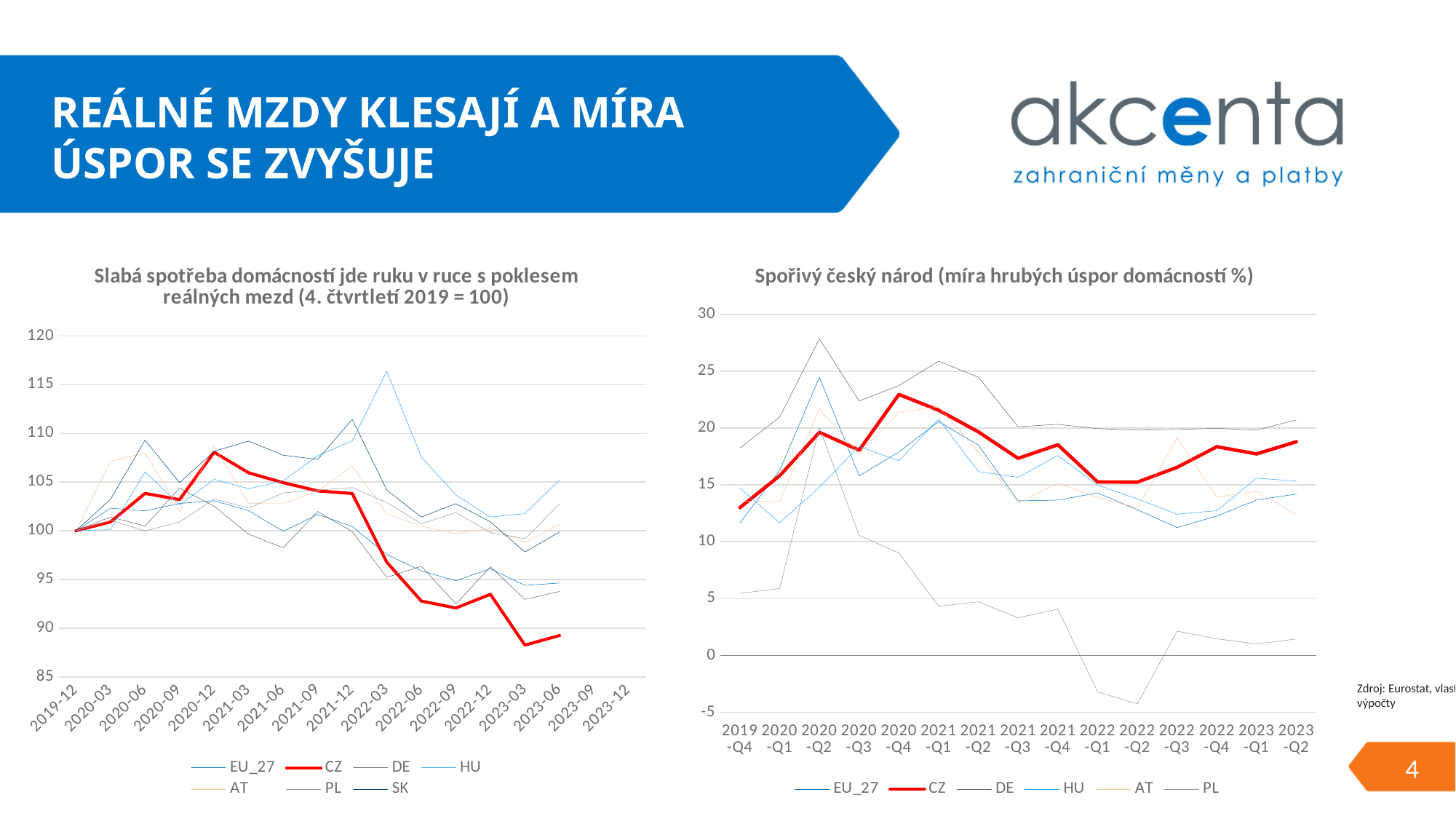
In the left chart (real wages index), which is larger at 2023-06: CZ or HU? HU In the left chart (real wages index), what is the value of CZ at 2019-12? 100 How many series does the legend of the right chart, 'Spořivý český národ', list? 6 In the left chart (real wages index), is the value for CZ at 2023-03 greater or less than 90? less In the right chart 'Spořivý český národ', how many quarters are shown on the x axis? 15 How many series does the legend of the left chart (real wages index) list? 7 In the left chart (real wages index), is the value for HU at 2022-03 greater or less than 115? greater In the left chart (real wages index), which series reaches the lowest value shown? CZ What kind of chart is the left chart, 'Slabá spotřeba domácností jde ruku v ruce s poklesem reálných mezd'? line chart In the right chart 'Spořivý český národ', is the value for PL at 2022-Q1 greater or less than 0? less In the right chart 'Spořivý český národ', which series has the highest value at 2020-Q2? DE